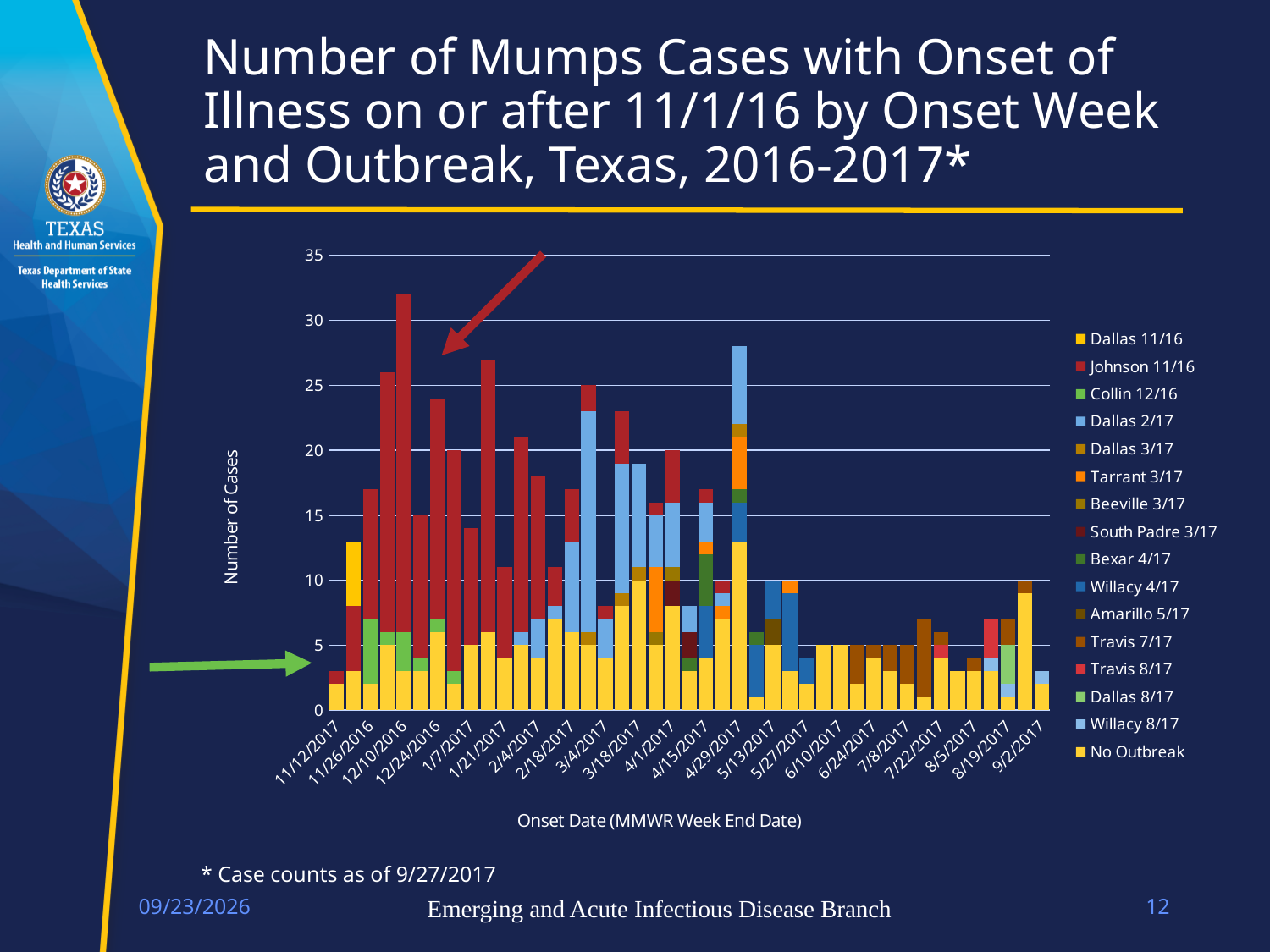
Is the value for the first bar (11/12) greater or less than 5 cases? less Is the tallest bar in the chart greater or less than 35 cases? less How many date labels are shown on the x axis? 22 What is the last entry in the chart legend? No Outbreak Is the tallest bar in the chart greater or less than 30 cases? greater How many series does the legend list? 16 What kind of chart is shown on the slide? Stacked bar chart What is the highest value shown on the y axis? 35 Do the weekly case counts generally rise or fall from left to right across the chart? fall